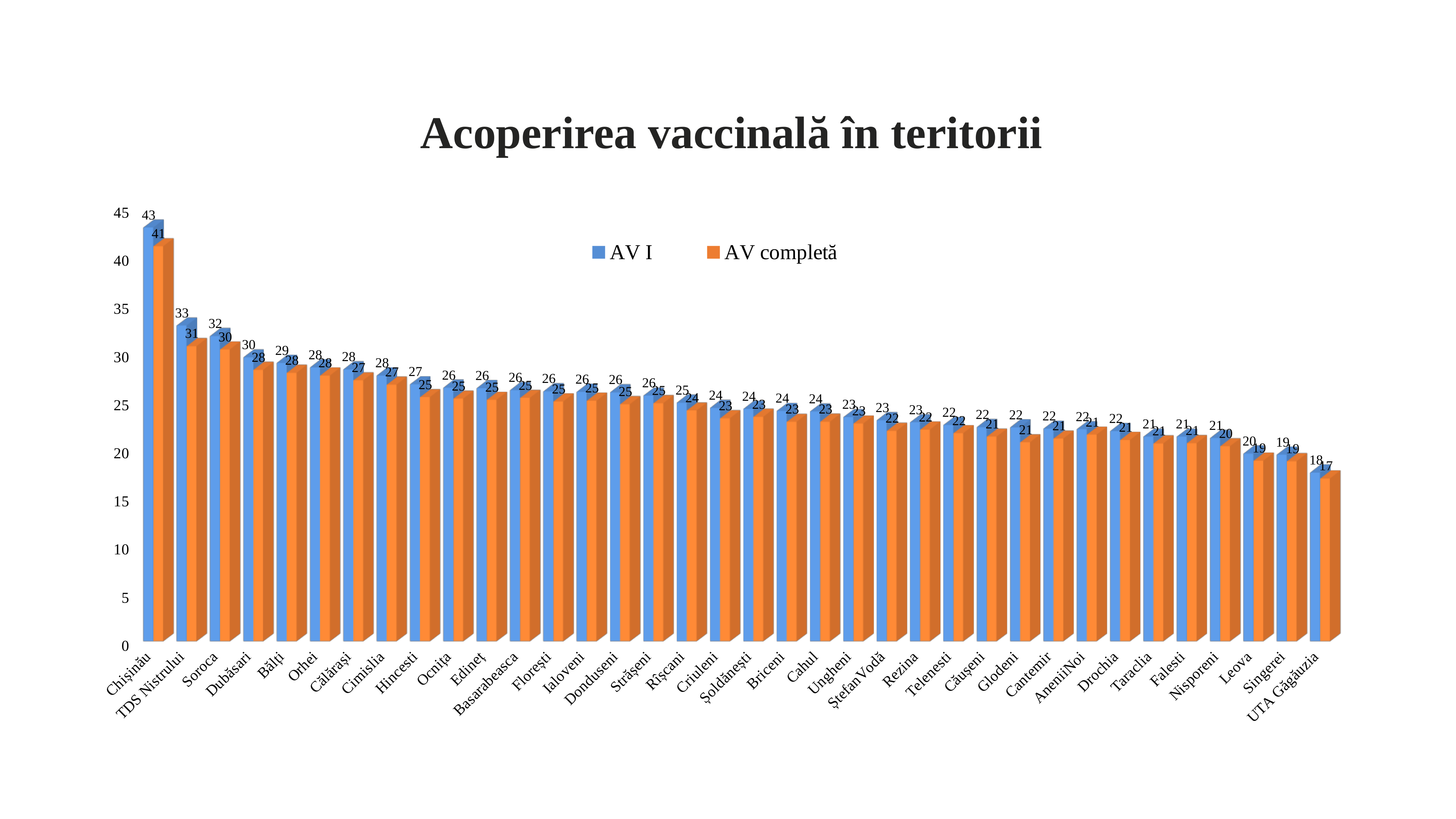
Which territory has the highest AV I value? Chișinău How many series does the legend list? 2 What is the difference between the AV I values for TDS Nistrului and Leova? 13 What is the difference between the AV I and AV completă values for Chișinău? 2 Which territory has the lowest AV completă value? UTA Găgăuzia Which is larger, the AV I value for Soroca or the AV I value for Dubăsari? Soroca What kind of chart is shown on the slide? Bar chart What is the AV I value for Hincesti? 27 What is the AV completă value for Soroca? 30 What is the AV I value for Chișinău? 43 How many territories are shown on the x axis? 36 What is the AV completă value for UTA Găgăuzia? 17